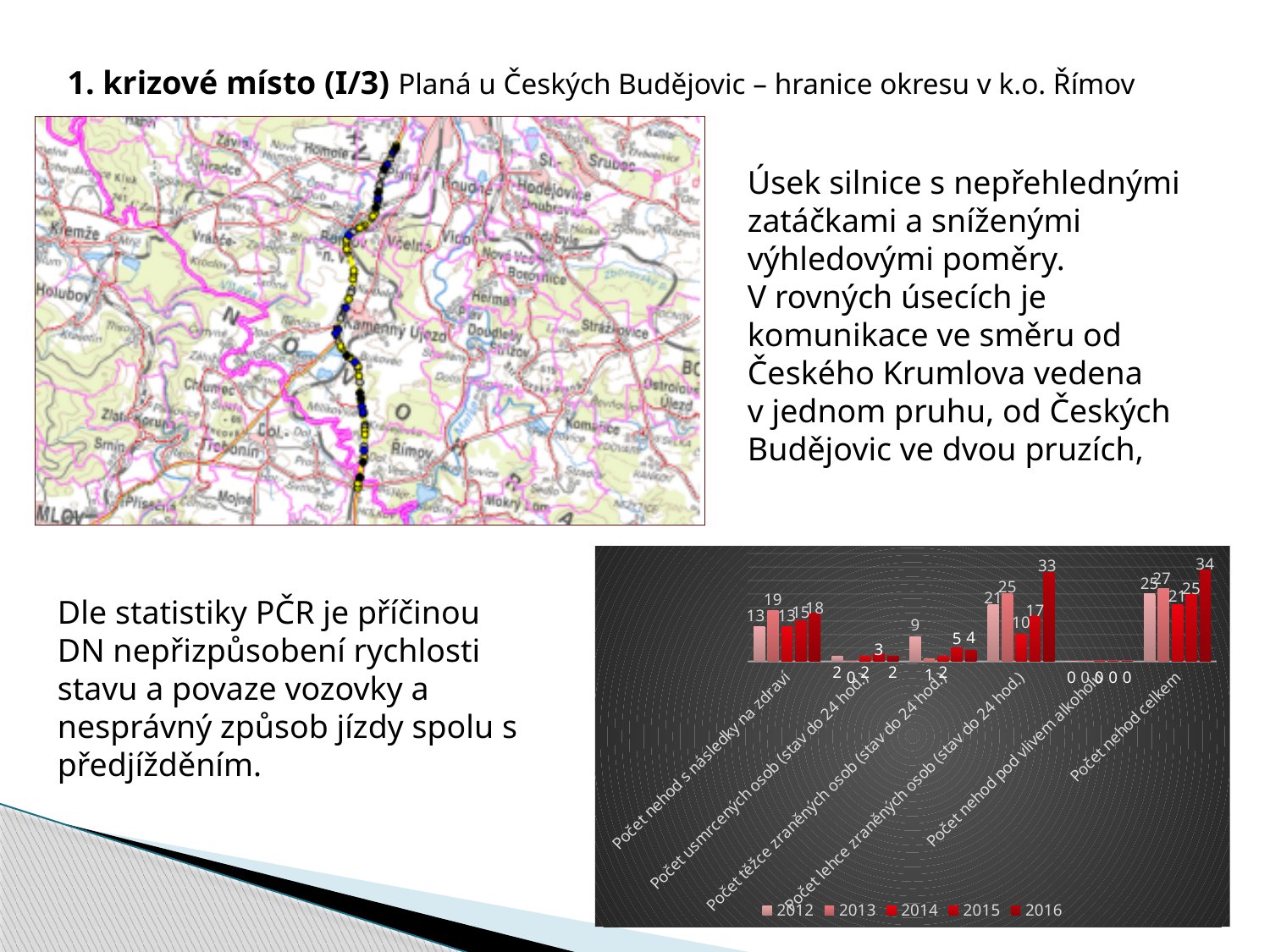
What kind of chart is shown on the slide? bar chart How many categories are shown on the chart's x axis? 6 What is the value for 2016 in the category 'Počet nehod celkem'? 34 How many series does the chart legend list? 5 Which is larger in the category 'Počet nehod s následky na zdraví': the value for 2012 or the value for 2016? 2016 Which year has the lowest value in the category 'Počet lehce zraněných osob (stav do 24 hod.)'? 2014 What is the value for 2016 in the category 'Počet lehce zraněných osob (stav do 24 hod.)'? 33 Which year has the highest value in the category 'Počet nehod celkem'? 2016 What is the value for 2013 in the category 'Počet nehod s následky na zdraví'? 19 What is the value for every year in the category 'Počet nehod pod vlivem alkoholu'? 0 What is the value for 2012 in the category 'Počet těžce zraněných osob (stav do 24 hod.)'? 9 What is the difference between the 2016 and 2014 values in the category 'Počet nehod celkem'? 13